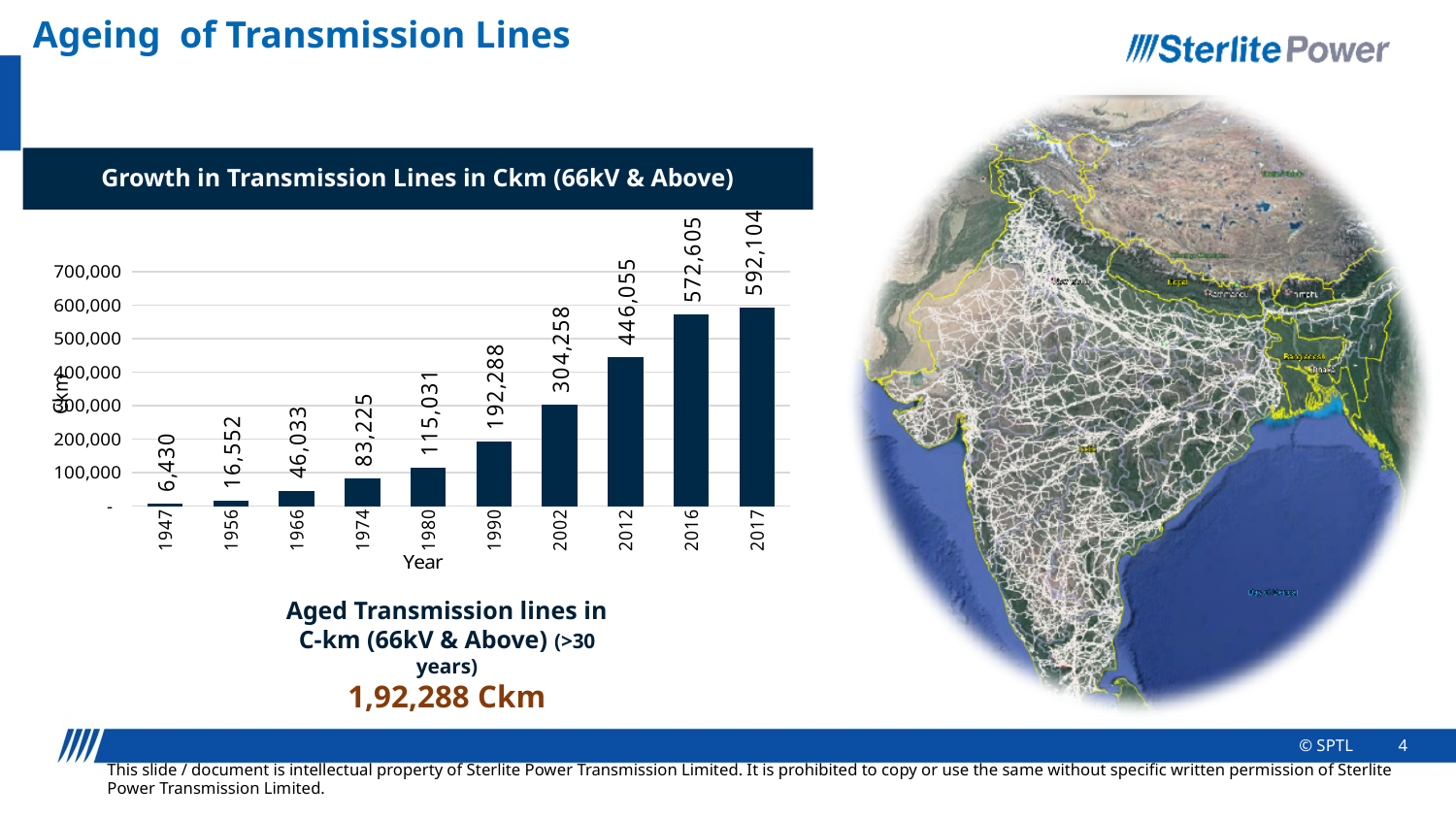
How many years are shown on the x axis of the Growth in Transmission Lines chart? 10 Do the values in the Growth in Transmission Lines chart rise or fall from 1947 to 2017? rise What is the difference between the values for 2017 and 2016 in the Growth in Transmission Lines chart? 19,499 What is the value for 1990 in the Growth in Transmission Lines chart? 192,288 What is the label of the y axis in the Growth in Transmission Lines chart? Ckm What is the value for 2012 in the Growth in Transmission Lines chart? 446,055 Which is larger in the Growth in Transmission Lines chart, the value for 1980 or the value for 1974? 1980 Which year has the highest value in the Growth in Transmission Lines chart? 2017 What is the value for 1947 in the Growth in Transmission Lines chart? 6,430 What kind of chart is the Growth in Transmission Lines chart? bar chart Which year has the lowest value in the Growth in Transmission Lines chart? 1947 Is the value for 2002 in the Growth in Transmission Lines chart greater or less than 300,000? greater